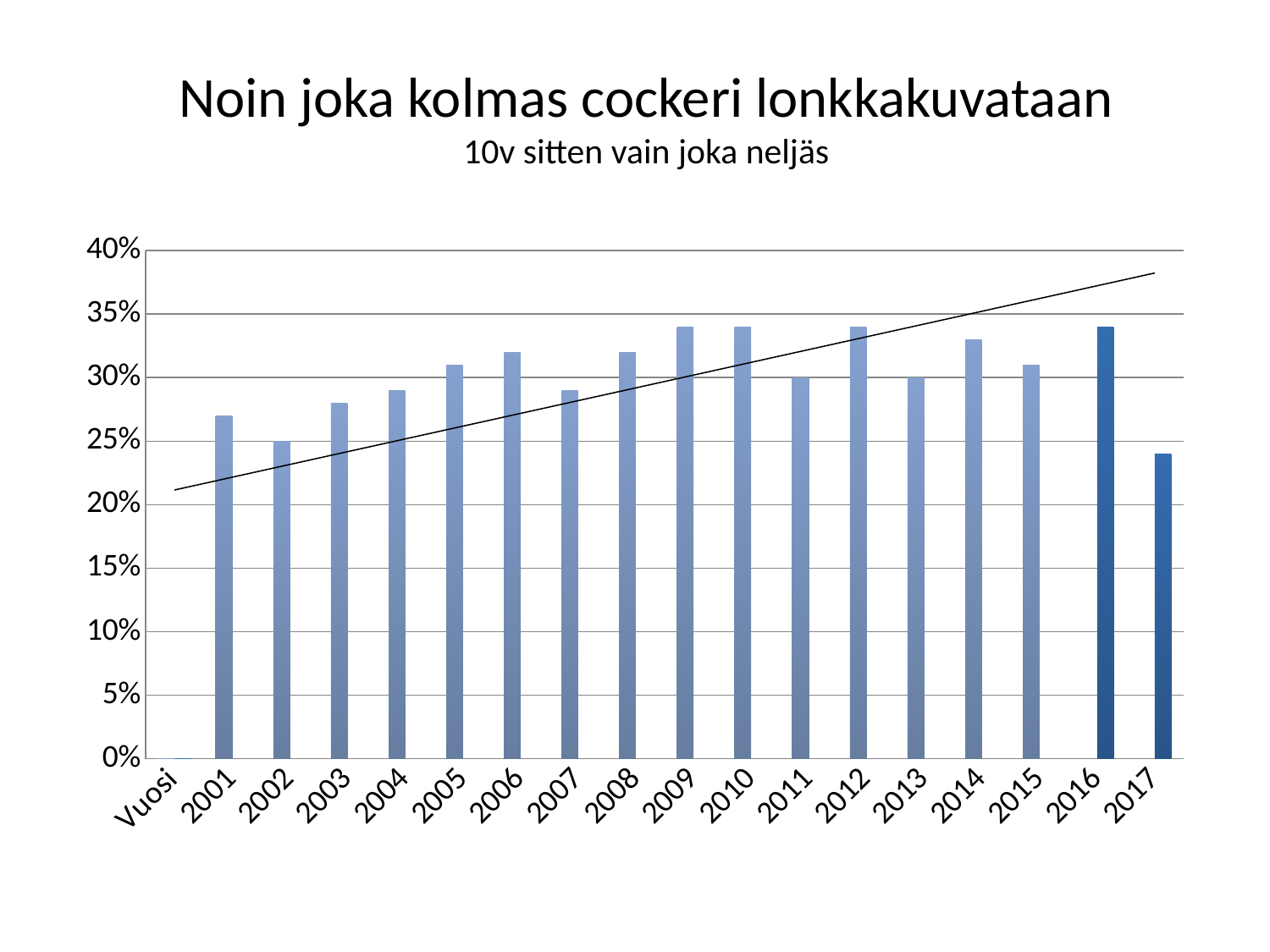
Is the value for 2005 greater or less than 30%? greater What kind of chart is shown on the slide? bar chart Which year has a higher value, 2005 or 2002? 2005 Which year has the lowest value in the chart? 2017 How many bars are plotted in the chart? 17 Does the straight trend line drawn across the chart rise or fall from left to right? rise What is the title of the chart on the slide? Noin joka kolmas cockeri lonkkakuvataan Is the value for 2001 greater or less than 25%? greater Is the value for 2004 greater or less than 30%? less Which year has a higher value, 2009 or 2017? 2009